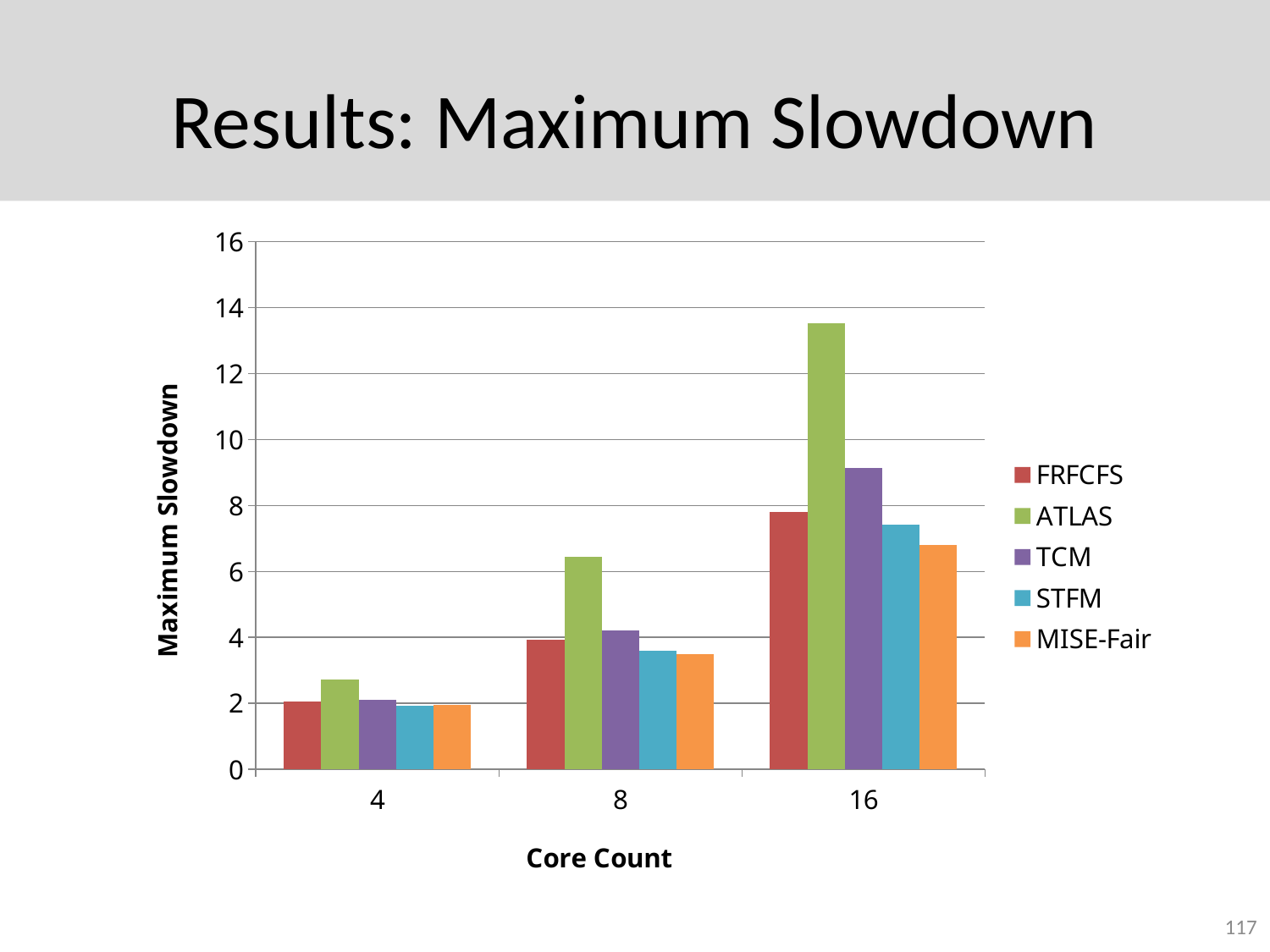
Which series has the highest maximum slowdown at a core count of 16? ATLAS How many series does the legend list? 5 Is the value for MISE-Fair at a core count of 8 greater or less than 4? less What kind of chart is shown on the slide? bar chart Which series has the lowest maximum slowdown at a core count of 16? MISE-Fair Is the value for ATLAS at a core count of 16 greater or less than 12? greater Does the maximum slowdown for ATLAS rise or fall as the core count increases from 4 to 16? rise Is the value for TCM at a core count of 16 greater or less than 8? greater Which series has the highest maximum slowdown at a core count of 8? ATLAS What is the title of the y axis? Maximum Slowdown At a core count of 8, which is larger, the value for ATLAS or the value for TCM? ATLAS How many core count categories are shown on the x axis? 3